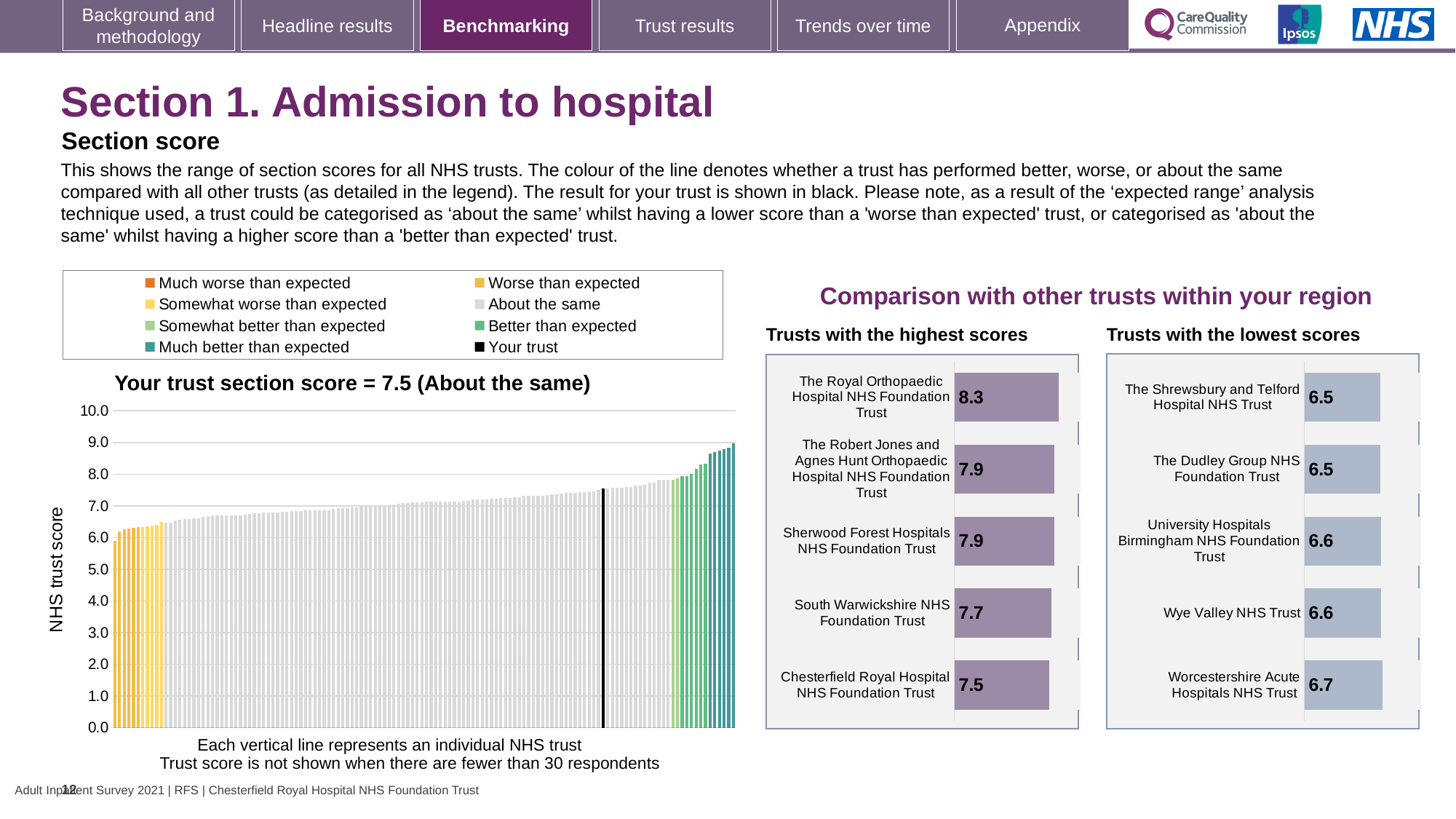
On the 'Your trust section score' chart, what is the section score for your trust? 7.5 On the 'Your trust section score' chart, is the value of the black bar for your trust greater or less than 7.0? greater What kind of chart is the 'Your trust section score' chart? bar chart On the 'Trusts with the highest scores' chart, which trust has the highest score? The Royal Orthopaedic Hospital NHS Foundation Trust On the 'Your trust section score' chart, do the bars rise or fall from left to right along the x axis? rise What is the y-axis label on the 'Your trust section score' chart? NHS trust score On the 'Trusts with the lowest scores' chart, what is the score for University Hospitals Birmingham NHS Foundation Trust? 6.6 How many trusts are shown on the 'Trusts with the lowest scores' chart? 5 On the 'Trusts with the highest scores' chart, what is the score for The Royal Orthopaedic Hospital NHS Foundation Trust? 8.3 How many entries does the legend above the 'Your trust section score' chart list? 8 On the 'Trusts with the highest scores' chart, what is the difference between the scores of The Royal Orthopaedic Hospital NHS Foundation Trust and Chesterfield Royal Hospital NHS Foundation Trust? 0.8 On the 'Trusts with the lowest scores' chart, which has the higher score, Worcestershire Acute Hospitals NHS Trust or Wye Valley NHS Trust? Worcestershire Acute Hospitals NHS Trust